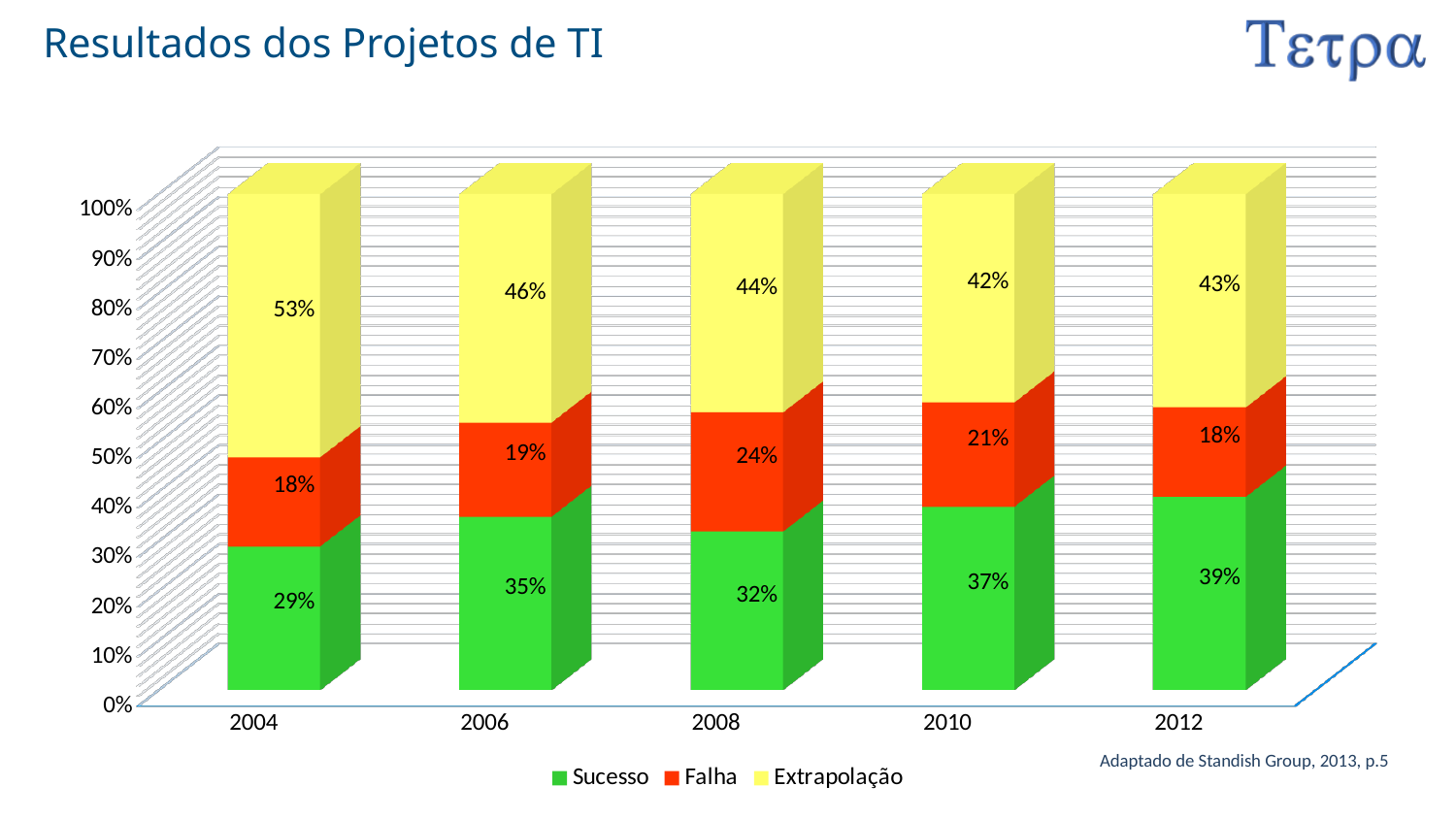
What is the Sucesso value for 2004? 29% How many series does the legend list? 3 What is the difference between the Sucesso values for 2012 and 2004? 10% Which year has the highest Sucesso value? 2012 How many years are shown on the x axis? 5 What is the Falha value for 2010? 21% What is the title of the slide? Resultados dos Projetos de TI Which year has the lowest Falha value? 2004 and 2012 What kind of chart is shown on the slide? Stacked bar chart What is the Extrapolação value for 2008? 44% Which year has the highest Extrapolação value? 2004 Is the Falha value for 2008 larger than the Falha value for 2006? Yes